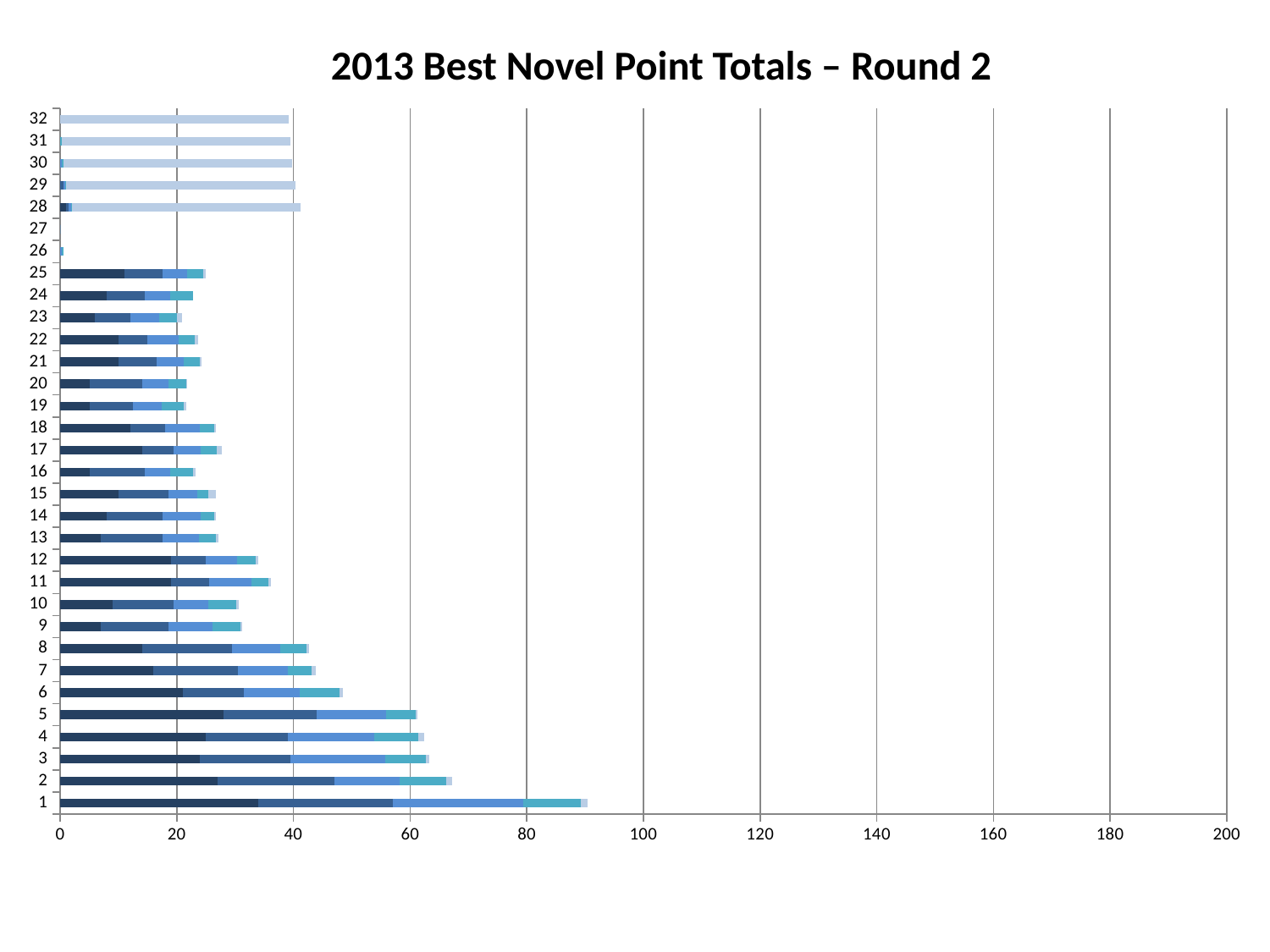
What kind of chart is shown on the slide? bar chart What is the highest value shown on the horizontal axis of the chart? 200 Is the total value for category 12 greater or less than 40? less Which has the larger total value, category 1 or category 2? category 1 Is the total value for category 1 greater or less than 80? greater Is the total value for category 25 greater or less than 20? greater How many categories are listed on the vertical axis of the chart? 32 Which category has the longest bar in the chart? 1 What is the title of the chart? 2013 Best Novel Point Totals – Round 2